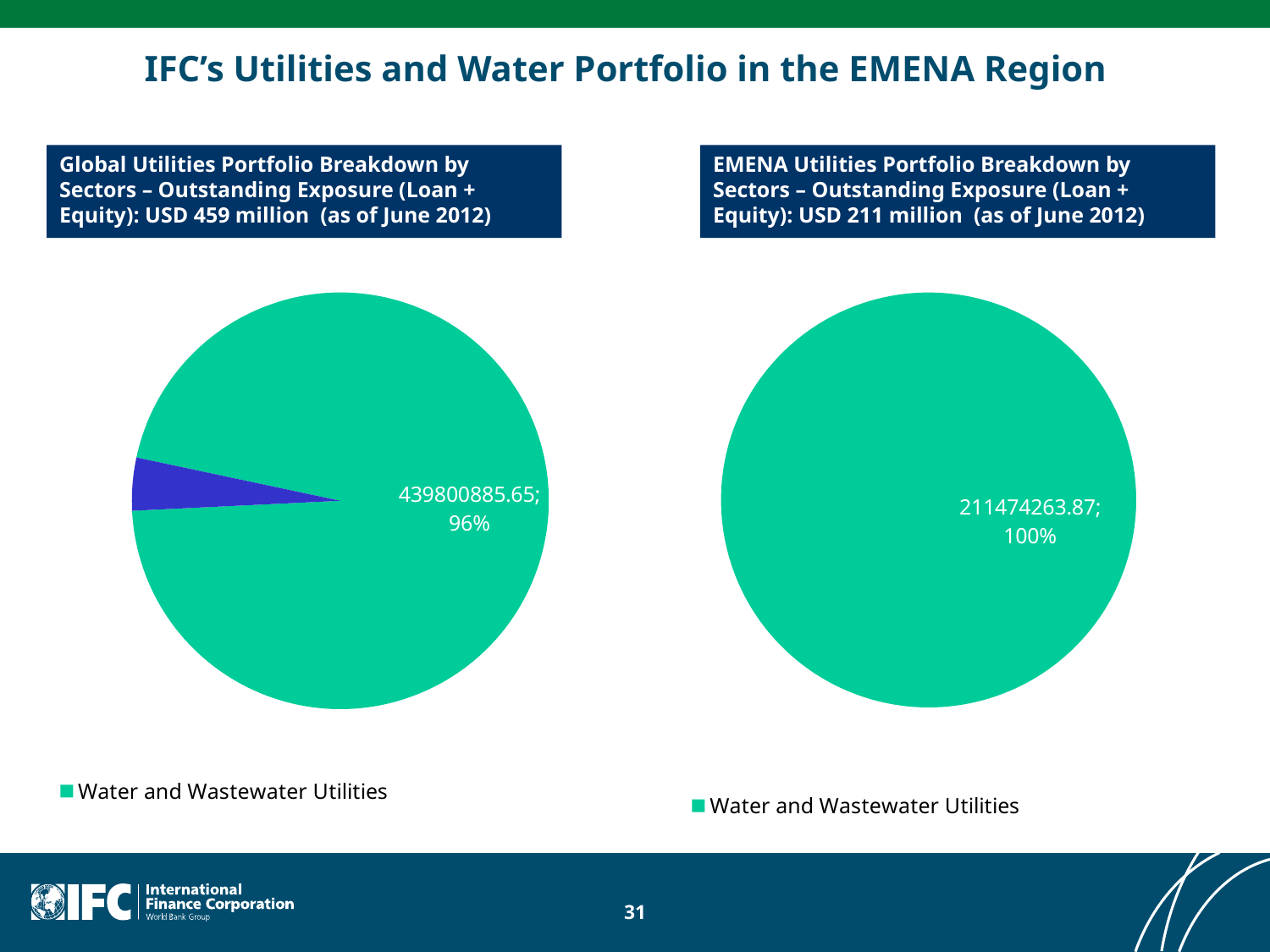
In the Global Utilities Portfolio Breakdown chart on the left, what value is shown for Water and Wastewater Utilities? 439800885.65 In the Global Utilities Portfolio Breakdown chart on the left, which is larger: the green Water and Wastewater Utilities slice or the blue slice? Water and Wastewater Utilities What kind of chart is the EMENA Utilities Portfolio Breakdown chart on the right? pie chart What colour is the Water and Wastewater Utilities slice in the EMENA Utilities Portfolio Breakdown chart on the right? green What is the only legend entry shown for the Global Utilities Portfolio Breakdown chart on the left? Water and Wastewater Utilities In the EMENA Utilities Portfolio Breakdown chart on the right, what share of the pie does Water and Wastewater Utilities represent? 100% In the Global Utilities Portfolio Breakdown chart on the left, is the share for Water and Wastewater Utilities greater or less than 90%? greater In the Global Utilities Portfolio Breakdown chart on the left, what share of the pie does Water and Wastewater Utilities represent? 96% What kind of chart is the Global Utilities Portfolio Breakdown chart on the left? pie chart In the EMENA Utilities Portfolio Breakdown chart on the right, what value is shown for Water and Wastewater Utilities? 211474263.87 How many entries does the legend of the EMENA Utilities Portfolio Breakdown chart on the right list? 1